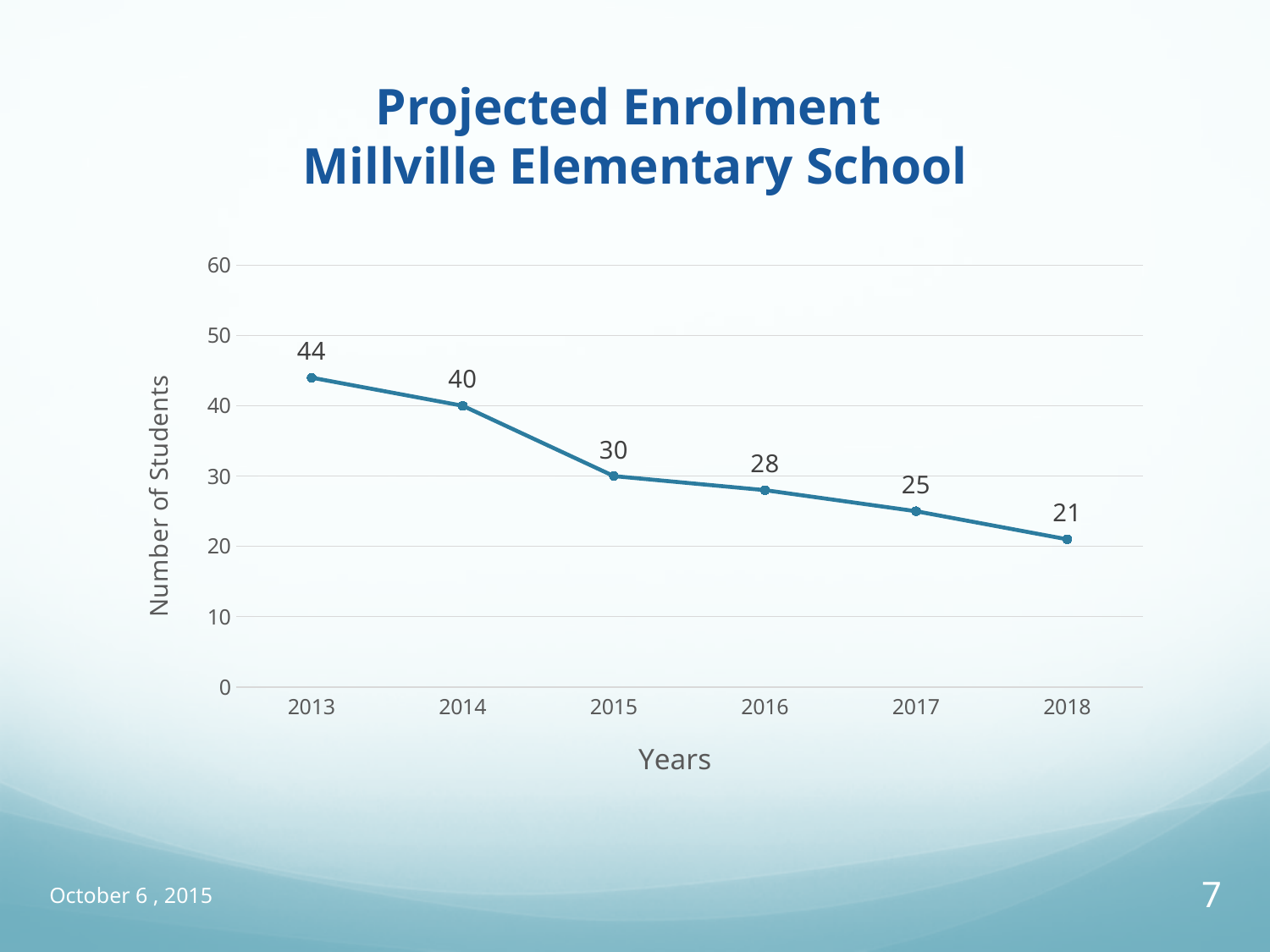
What is the projected enrolment for 2016? 28 Which year has a larger projected enrolment, 2015 or 2017? 2015 What is the projected enrolment for 2018? 21 What kind of chart is shown on the slide? Line chart Which year has the highest projected enrolment? 2013 Does the projected enrolment rise or fall from 2013 to 2018? Fall What is the difference in projected enrolment between 2013 and 2018? 23 What is the difference in projected enrolment between 2014 and 2015? 10 Which year has the lowest projected enrolment? 2018 How many years are plotted on the chart? 6 What is the projected enrolment for 2013? 44 Is the projected enrolment for 2014 greater or less than 30? greater